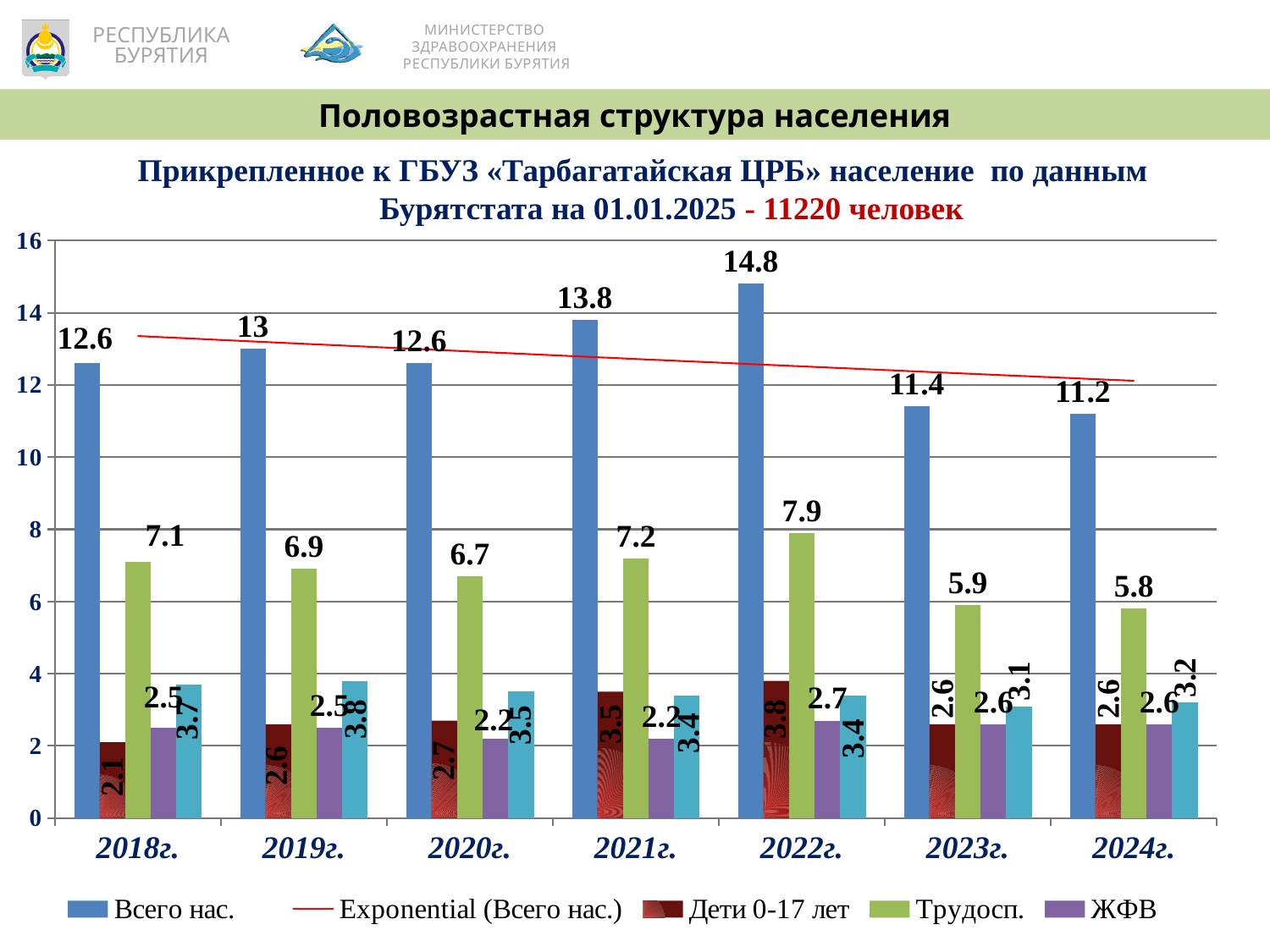
What colour are the Всего нас. bars? Blue How many years are shown on the x axis? 7 What is the value of Трудосп. for 2020г.? 6.7 Does the Всего нас. value rise or fall from 2022г. to 2024г.? Fall In which year is the Всего нас. value the lowest? 2024г. What is the value of Всего нас. for 2022г.? 14.8 What is the difference between the Всего нас. values for 2022г. and 2024г.? 3.6 In which year is the Всего нас. value the highest? 2022г. Which year has the larger Дети 0-17 лет value, 2021г. or 2022г.? 2022г. What kind of chart is shown on the slide? Bar chart What is the value of ЖФВ for 2022г.? 2.7 In which year is the Трудосп. value the highest? 2022г.